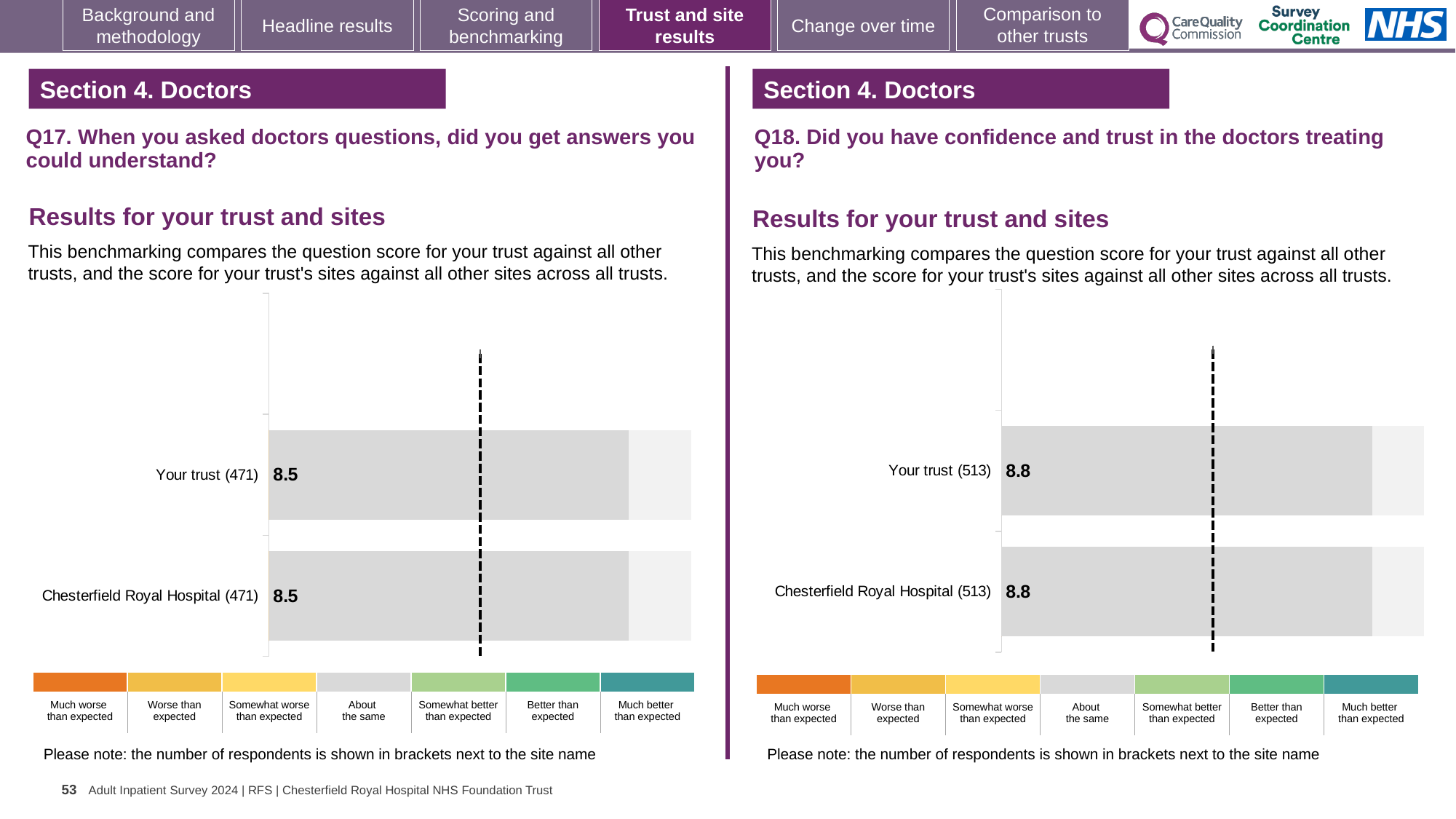
In the Q17 chart on the left, how many respondents are shown in brackets for Your trust? 471 How many bars are plotted in the Q18 chart on the right? 2 In the Q18 chart on the right, what is the score for Chesterfield Royal Hospital? 8.8 In the Q18 chart on the right, how many respondents are shown in brackets for Chesterfield Royal Hospital? 513 In the Q17 chart on the left, what is the score for Your trust? 8.5 Which is larger: the Your trust score in the Q18 chart on the right or the Your trust score in the Q17 chart on the left? Q18 chart (8.8) What is the difference between the Your trust score in the Q18 chart and the Your trust score in the Q17 chart? 0.3 In the Q18 chart on the right, what is the score for Your trust? 8.8 How many bars are plotted in the Q17 chart on the left? 2 What kind of chart is used for the Q17 results on the left? Bar chart In the Q17 chart on the left, what is the score for Chesterfield Royal Hospital? 8.5